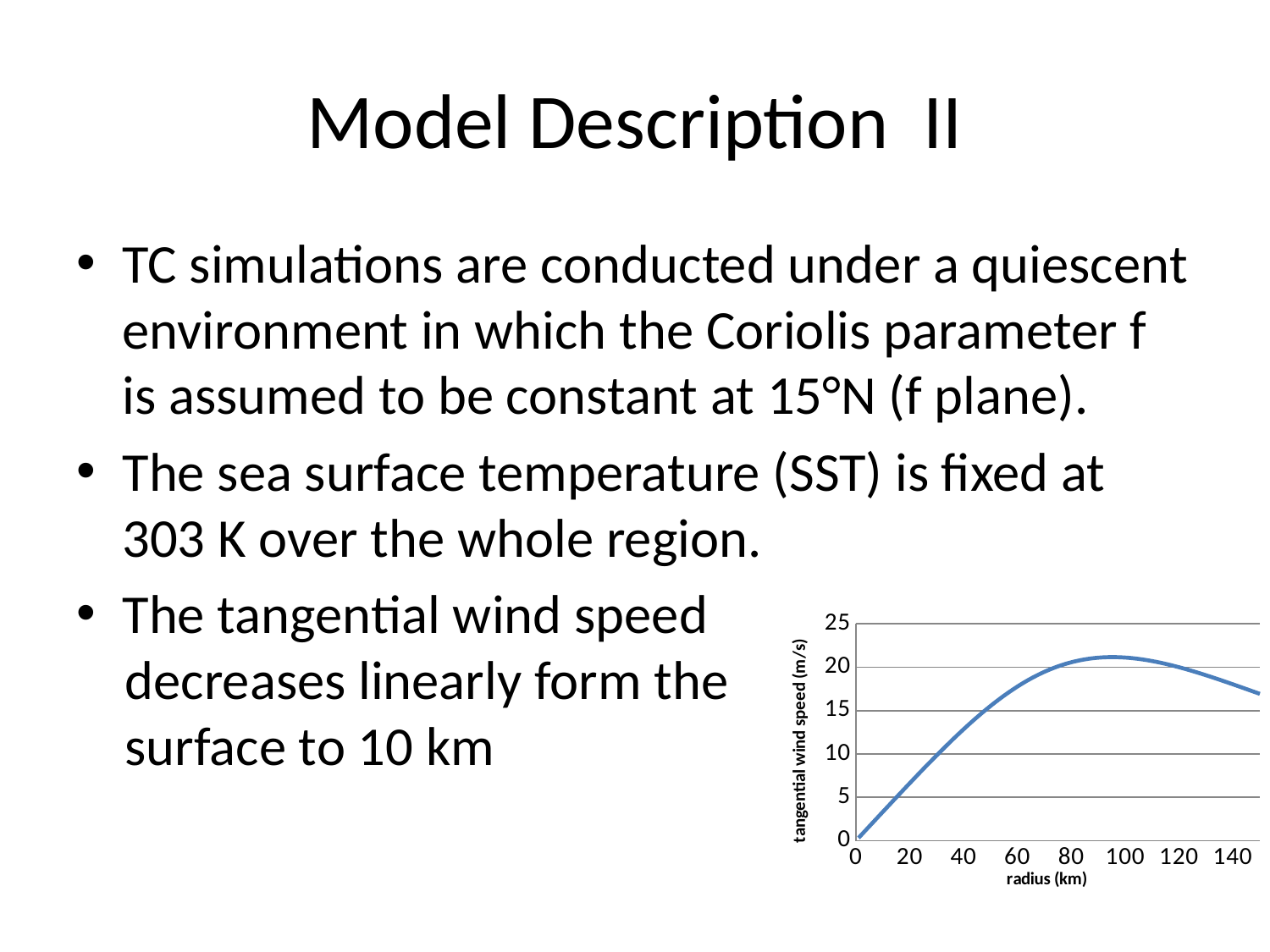
What is the label of the y axis of the chart? tangential wind speed (m/s) Is the tangential wind speed at a radius of 40 km greater or less than 10? greater Which is larger, the tangential wind speed at a radius of 20 km or at a radius of 100 km? 100 km Is the maximum tangential wind speed on the chart greater or less than 25? less What is the label of the x axis of the chart? radius (km) Is the tangential wind speed at a radius of 140 km greater or less than 20? less Does the tangential wind speed rise or fall as the radius increases from 0 km to 80 km? rise What kind of chart is shown on the slide? line chart